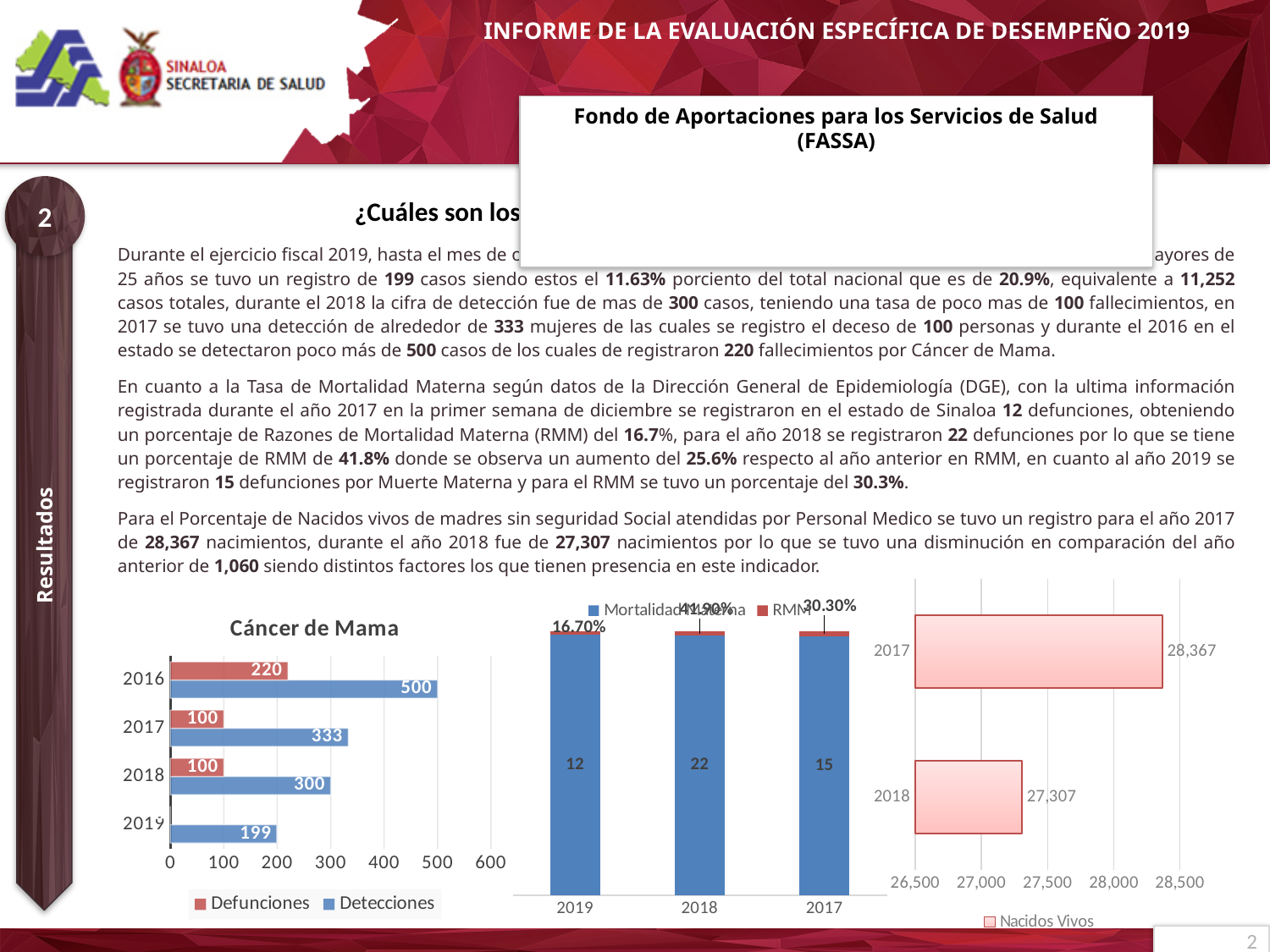
In the Cáncer de Mama chart, what is the value of Detecciones for 2019? 199 In the Cáncer de Mama chart, what is the difference between Detecciones and Defunciones for 2017? 233 In the Nacidos Vivos chart on the right, what is the value for 2017? 28,367 In the Cáncer de Mama chart, how many series does the legend list? 2 In the Nacidos Vivos chart on the right, what is the difference between the 2017 and 2018 values? 1,060 In the middle chart (Mortalidad Materna / RMM), what is the Mortalidad Materna value for 2018? 22 In the Cáncer de Mama chart, what is the value of Detecciones for 2016? 500 In the Cáncer de Mama chart, what is the value of Defunciones for 2016? 220 In the middle chart (Mortalidad Materna / RMM), which year has the lowest Mortalidad Materna value? 2019 In the middle chart (Mortalidad Materna / RMM), what is the RMM value for 2017? 30.30% What kind of chart is the Cáncer de Mama chart? Bar chart In the Cáncer de Mama chart, which year has the highest Detecciones value? 2016